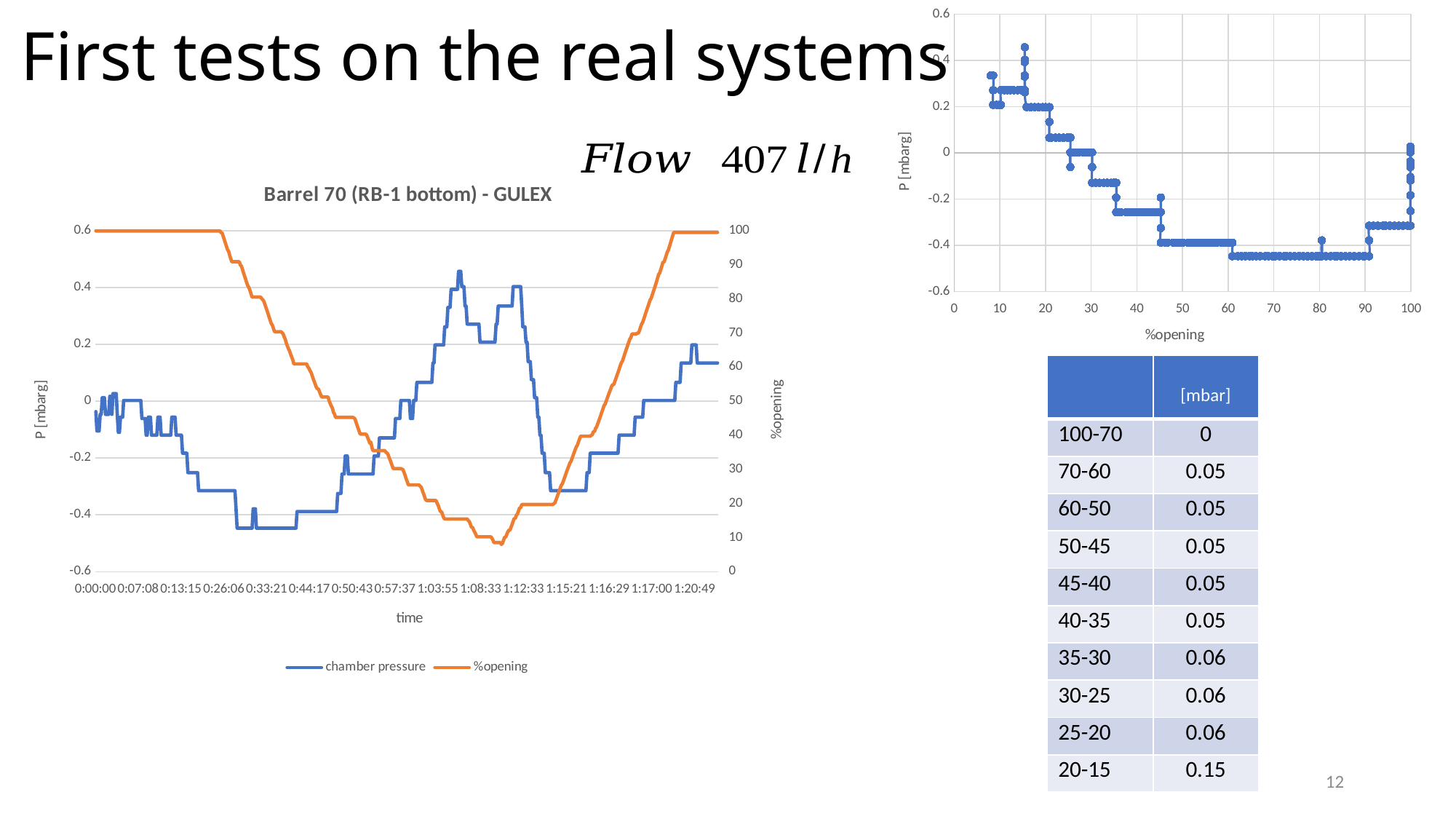
In the 'Barrel 70 (RB-1 bottom) - GULEX' chart, does the %opening series rise or fall between 0:26:06 and 1:08:33? fall How many series does the legend of the 'Barrel 70 (RB-1 bottom) - GULEX' chart list? 2 In the 'Barrel 70 (RB-1 bottom) - GULEX' chart, what is the %opening value at time 0:00:00? 100 In the top-right scatter chart, does P rise or fall as %opening increases from 10 to 70? fall In the top-right scatter chart, what is the title of the x axis? %opening What kind of chart is the 'Barrel 70 (RB-1 bottom) - GULEX' chart? line chart In the top-right scatter chart, is the value of P at %opening 15 greater or less than 0.2? greater What are the two series named in the legend of the 'Barrel 70 (RB-1 bottom) - GULEX' chart? chamber pressure and %opening In the top-right scatter chart, is the value of P at %opening 70 greater or less than -0.4? less In the top-right scatter chart, is the value of P at %opening 40 greater or less than -0.2? less What kind of chart is the chart in the top right of the slide, plotting P [mbarg] against %opening? scatter chart